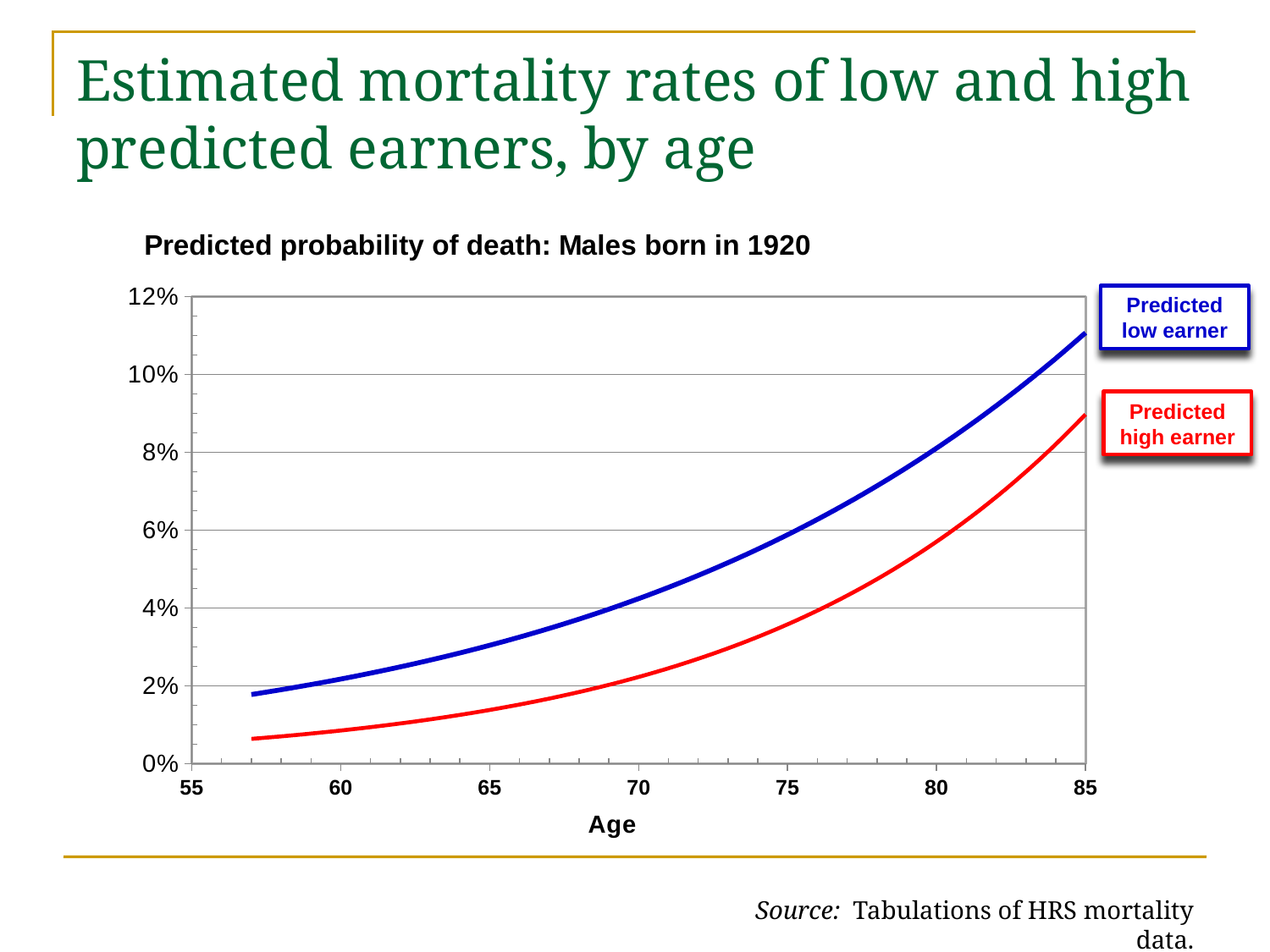
Is the value for Predicted low earner at age 85 greater or less than 10%? greater How many series does the chart show? 2 Is the value for Predicted high earner at age 80 greater or less than 6%? less Which series is plotted in blue? Predicted low earner Is the value for Predicted high earner at age 85 greater or less than 10%? less Do the predicted mortality rates rise or fall as age increases? rise What is the title printed above the chart? Predicted probability of death: Males born in 1920 At age 85, which series has the higher predicted probability of death, Predicted low earner or Predicted high earner? Predicted low earner What kind of chart is shown on the slide? line chart